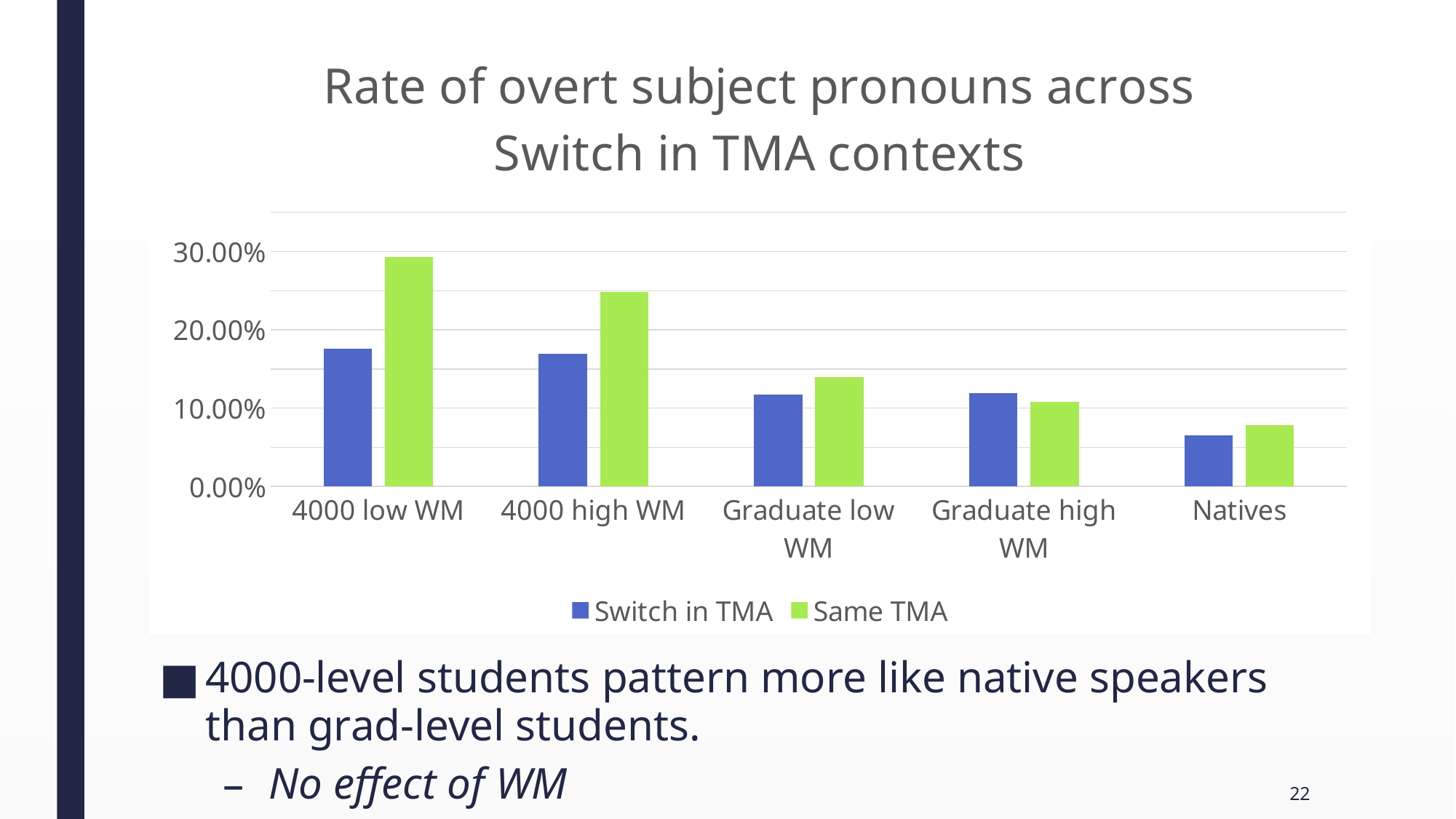
How many series does the chart's legend list? 2 Do the Same TMA values rise or fall moving from 4000 low WM to Natives along the x axis? fall Is the Same TMA value for 4000 low WM greater or less than 20.00%? greater Is the Switch in TMA value for 4000 low WM greater or less than 20.00%? less Which category has the lowest Same TMA value? Natives What kind of chart is shown on the slide? bar chart Is the Switch in TMA value for Natives greater or less than 10.00%? less For Graduate high WM, which is larger: Switch in TMA or Same TMA? Switch in TMA Which category has the lowest Switch in TMA value? Natives For 4000 low WM, which is larger: Switch in TMA or Same TMA? Same TMA Which category has the highest Same TMA value? 4000 low WM How many categories are shown on the x axis of the chart? 5